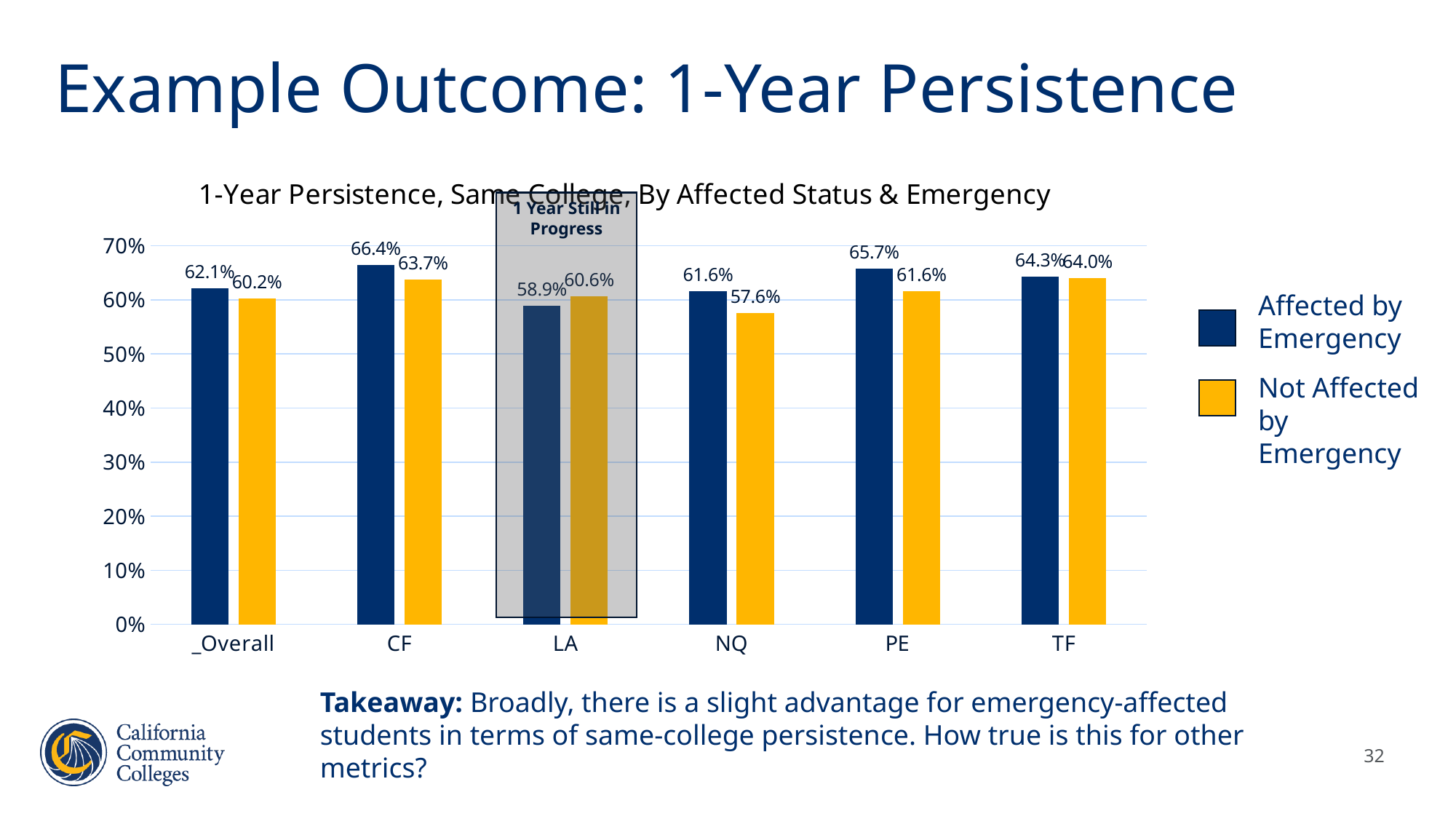
For LA, which series has the larger value: Affected by Emergency or Not Affected by Emergency? Not Affected by Emergency What kind of chart is shown on the slide? bar chart Which category has the lowest value in the Not Affected by Emergency series? NQ What is the difference between the Affected by Emergency and Not Affected by Emergency values for PE? 4.1% What is the value for NQ in the Not Affected by Emergency series? 57.6% What is the value for _Overall in the Not Affected by Emergency series? 60.2% What colour represents the Affected by Emergency series? dark blue How many series does the legend list? 2 Is the Not Affected by Emergency value for NQ greater or less than 60%? less Which category has the highest value in the Affected by Emergency series? CF How many categories are shown on the x axis? 6 What is the value for CF in the Affected by Emergency series? 66.4%